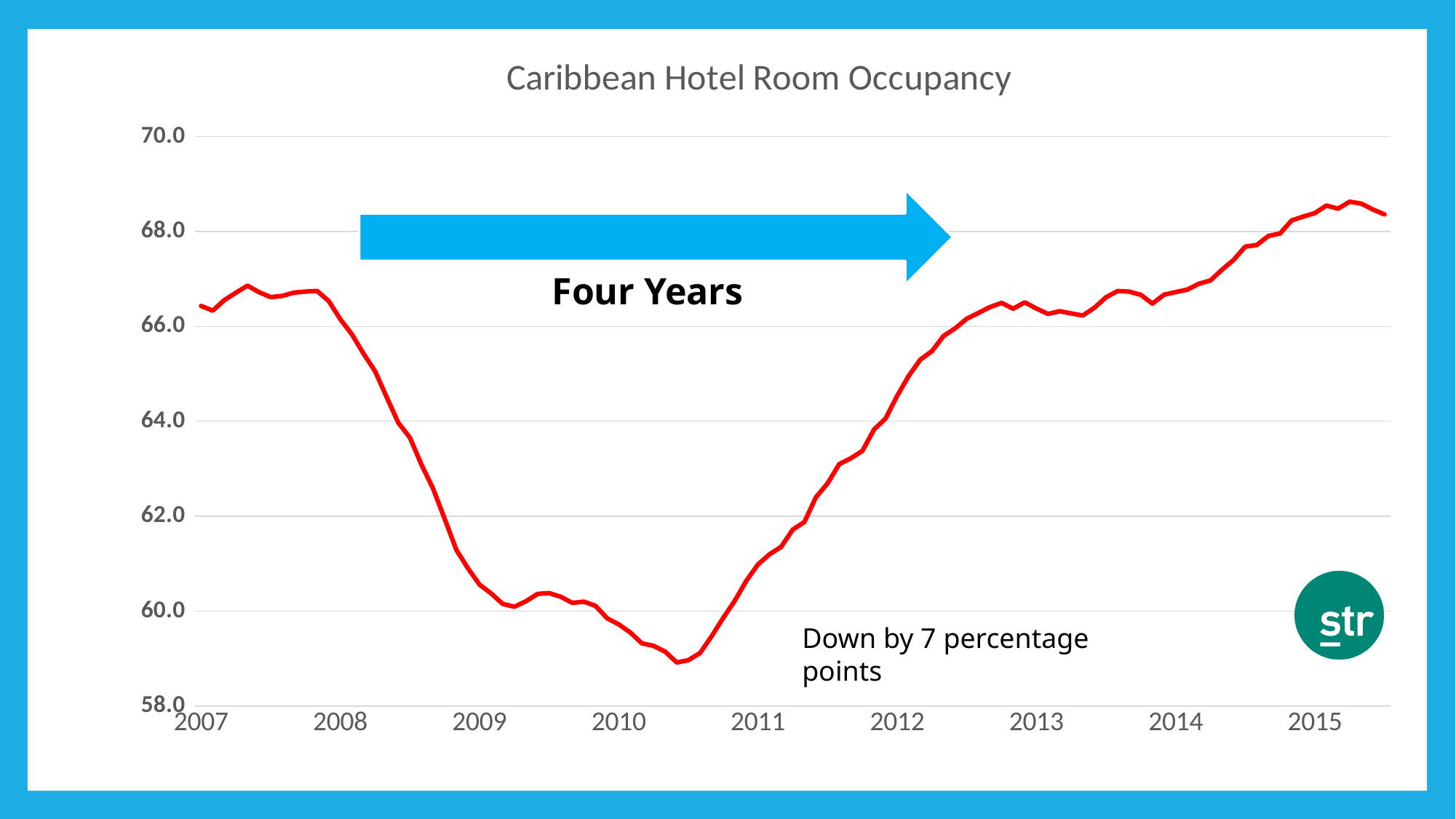
In which year labelled on the x axis does the line reach its lowest point? 2010 Is the value at the start of 2012 greater or less than 66.0? less How many years are labelled on the x axis? 9 How many lines are plotted on the chart? 1 What is the title of the chart? Caribbean Hotel Room Occupancy Is the lowest value of the line greater or less than 60.0? less Does the occupancy line rise or fall between 2008 and 2010? fall What kind of chart is shown on the slide? line chart In which year labelled on the x axis does the line reach its highest point? 2015 What does the annotation near the bottom of the chart say the occupancy was down by? 7 percentage points Does the occupancy line rise or fall between 2011 and 2015? rise